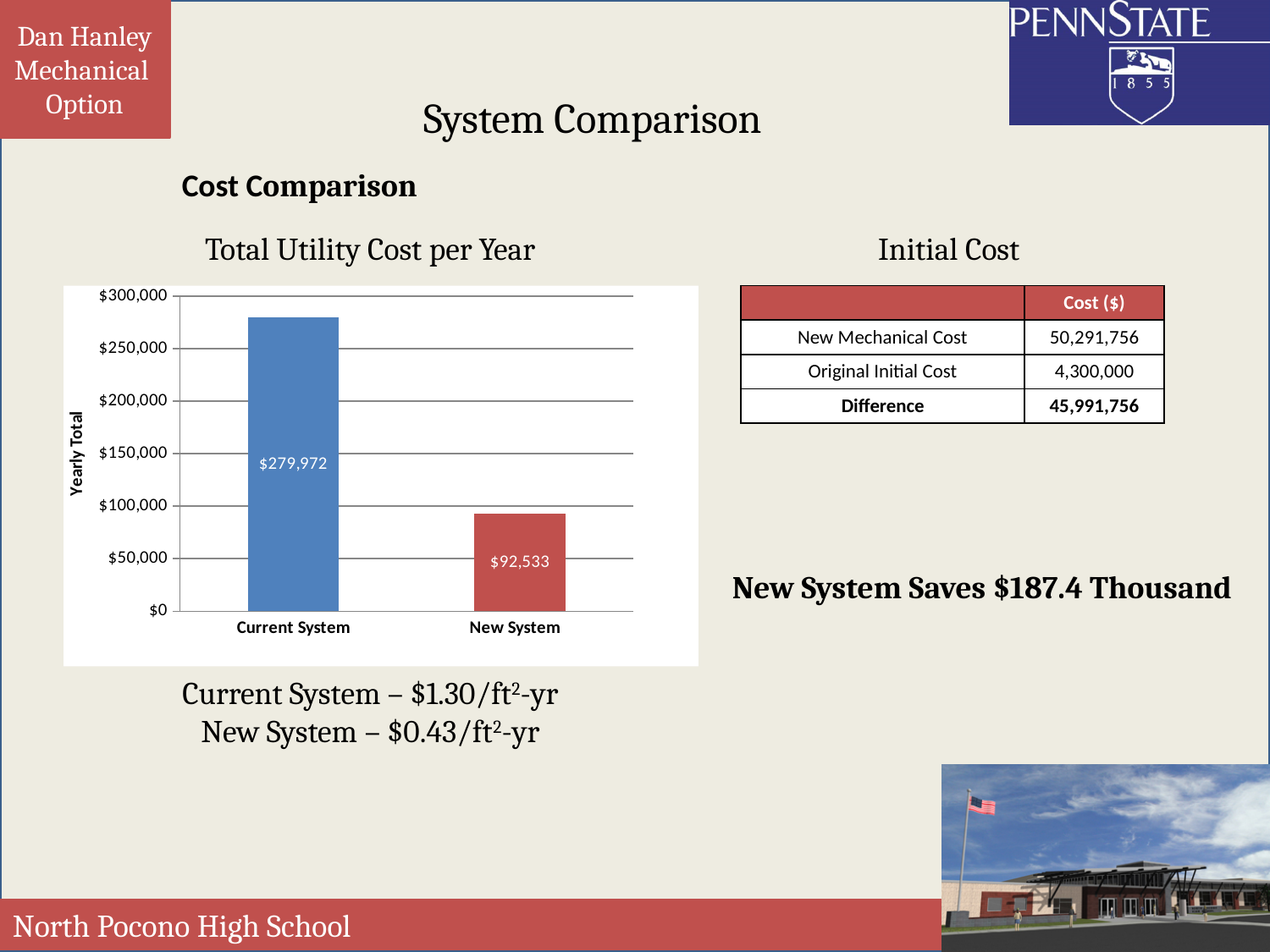
Which category has the lowest value in the Total Utility Cost per Year chart? New System What is the difference between the Current System and New System values in the Total Utility Cost per Year chart? $187,439 Which category has the highest value in the Total Utility Cost per Year chart? Current System What is the value for Current System in the Total Utility Cost per Year chart? $279,972 What kind of chart is the Total Utility Cost per Year chart? bar chart In the Total Utility Cost per Year chart, is the value for Current System greater or less than $250,000? greater What is the y-axis label of the Total Utility Cost per Year chart? Yearly Total In the Total Utility Cost per Year chart, is the value for New System greater or less than $100,000? less What is the value for New System in the Total Utility Cost per Year chart? $92,533 How many categories are shown in the Total Utility Cost per Year chart? 2 What colour is the Current System bar in the Total Utility Cost per Year chart? blue In the Total Utility Cost per Year chart, which is larger: the value for Current System or the value for New System? Current System